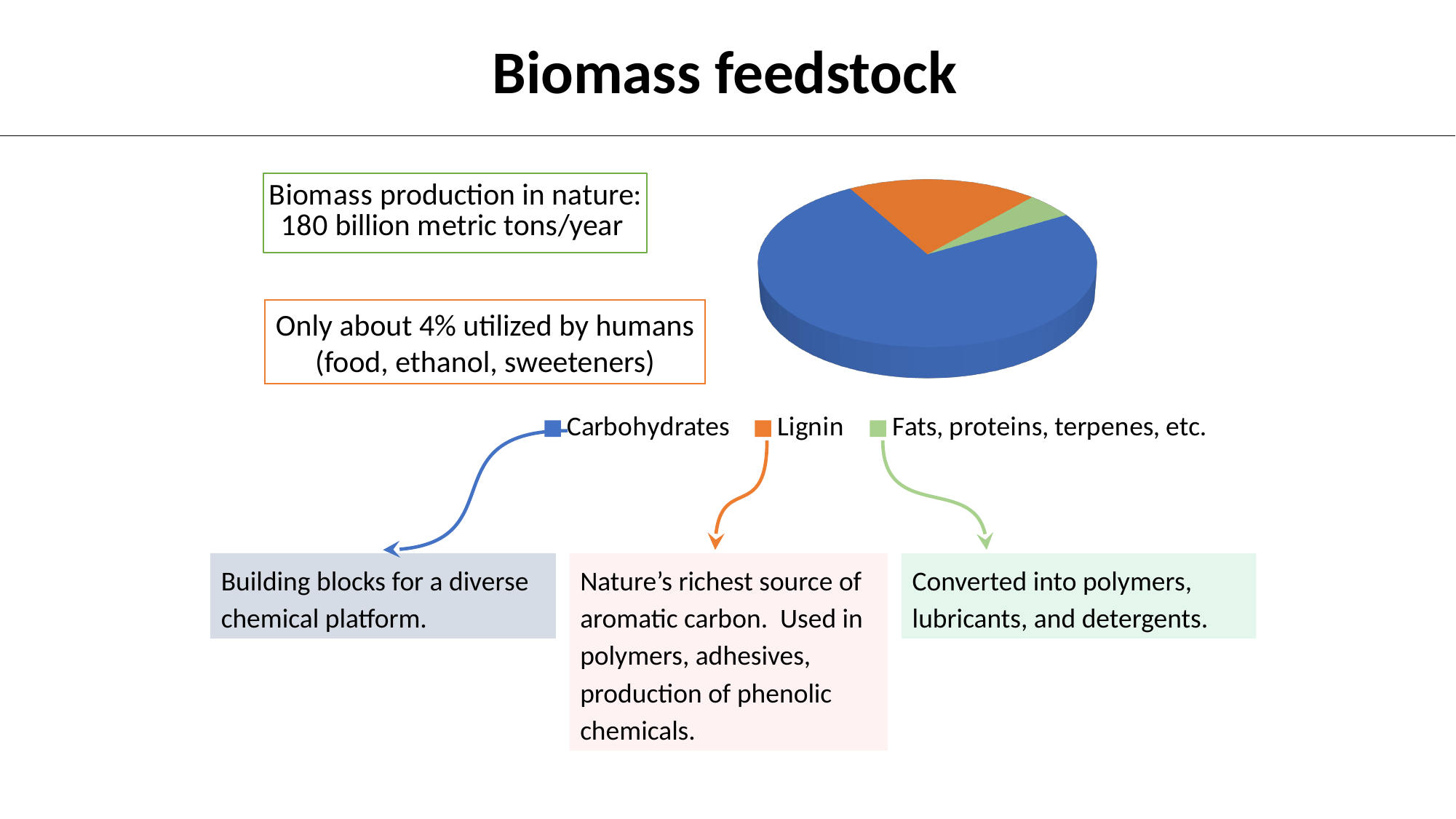
What kind of chart is shown on the slide? pie chart How many entries does the pie chart's legend list? 3 Which slice is larger in the pie chart, Lignin or Fats, proteins, terpenes, etc.? Lignin Which slice is larger in the pie chart, Carbohydrates or Lignin? Carbohydrates Which category has the smallest slice of the pie chart? Fats, proteins, terpenes, etc. Which category has the largest slice of the pie chart? Carbohydrates Which category is shown in green in the pie chart? Fats, proteins, terpenes, etc. How many slices does the pie chart have? 3 What colour is the Lignin slice in the pie chart? orange